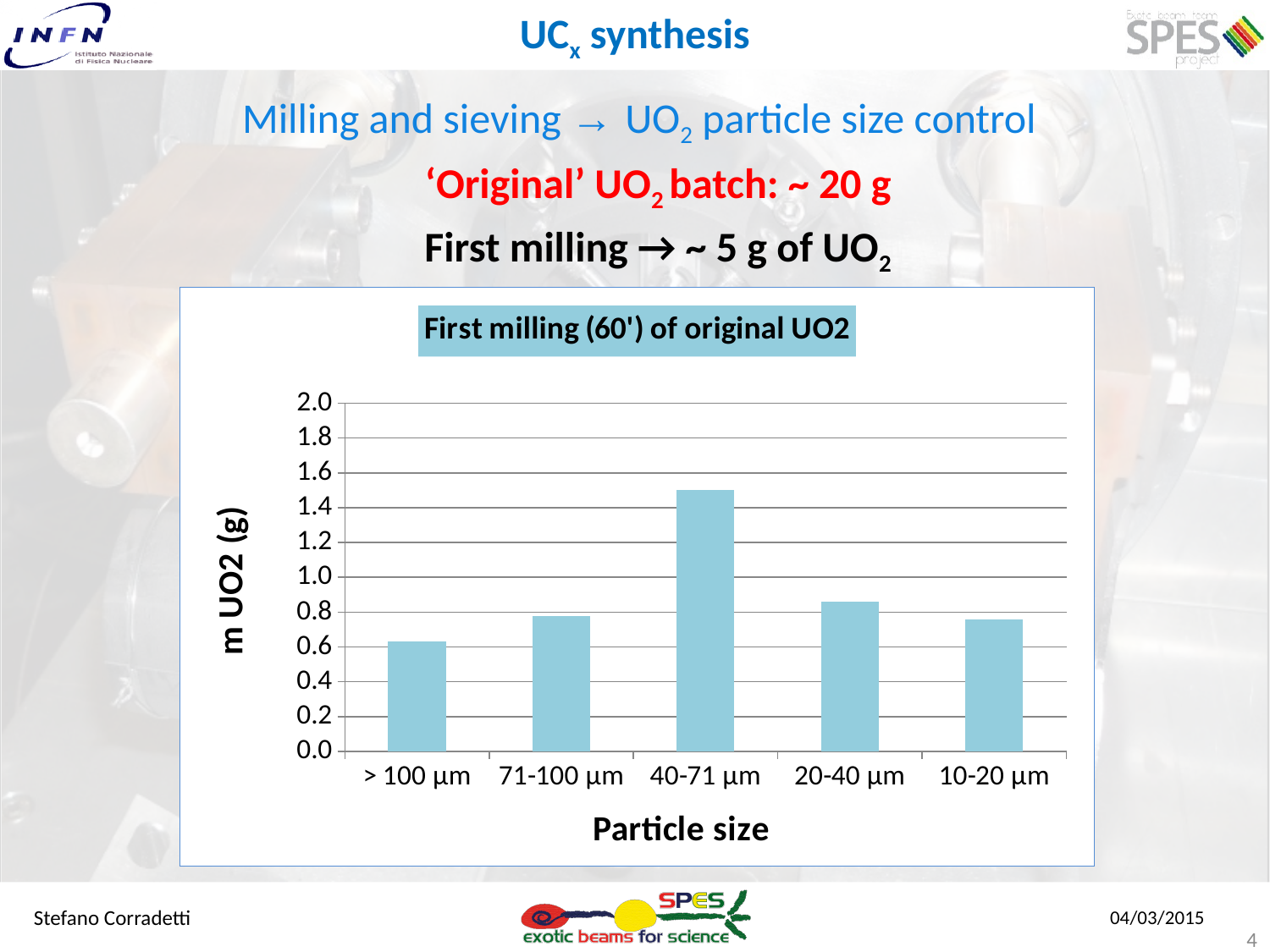
What kind of chart is shown on the slide? bar chart Is the value for 10-20 µm greater or less than 0.6? greater How many particle size categories are plotted in the chart? 5 What is the title of the chart? First milling (60') of original UO2 Is the value for 20-40 µm greater or less than 1.0? less Is the value for 40-71 µm greater or less than 1.6? less Which has a larger value, 40-71 µm or > 100 µm? 40-71 µm What is the label of the y axis of the chart? m UO2 (g) Which particle size category has the highest mass of UO2? 40-71 µm Which particle size category has the lowest mass of UO2? > 100 µm